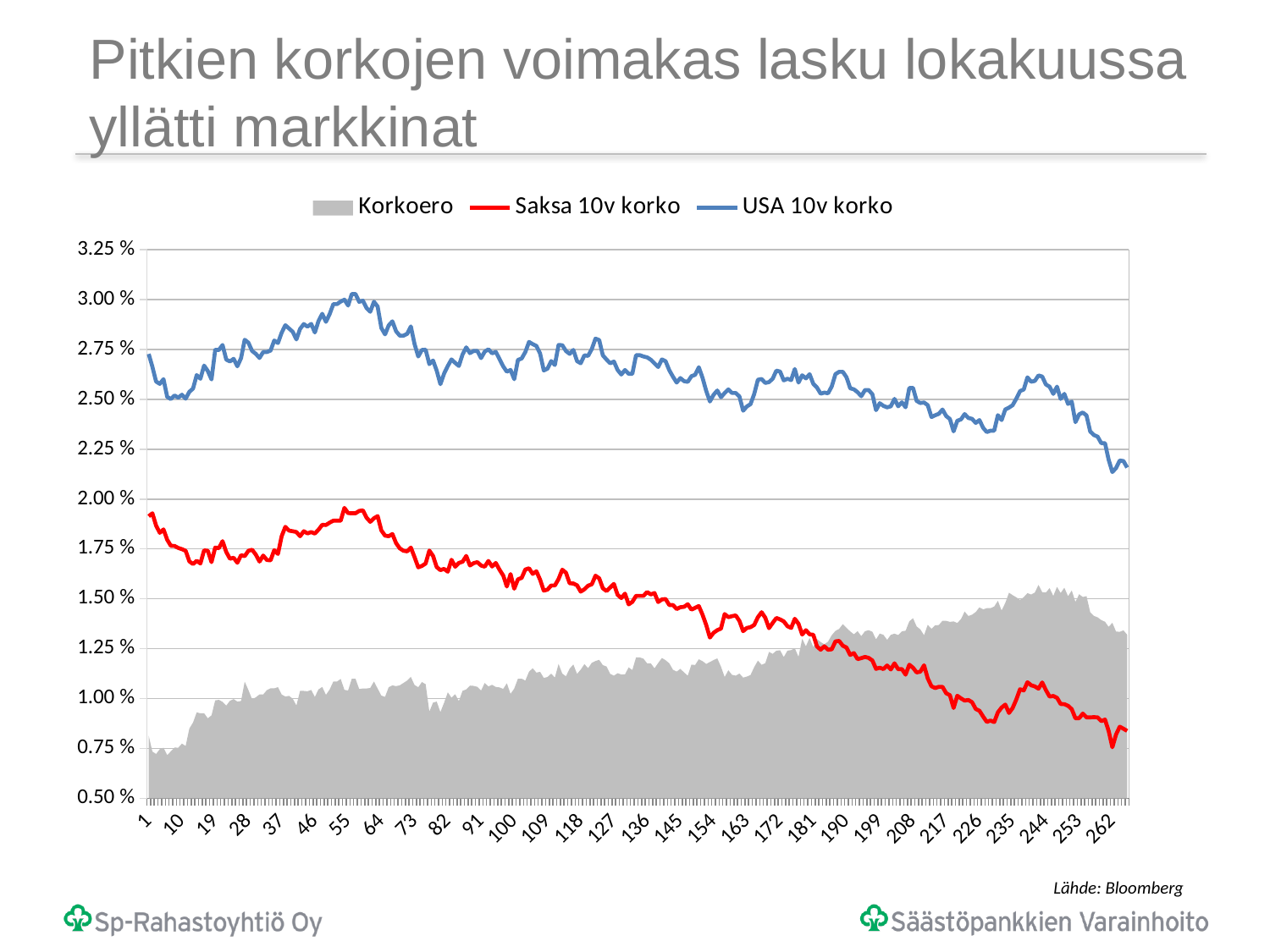
What kind of chart is used for the Saksa 10v korko and USA 10v korko series? line chart What colour is the Saksa 10v korko line? red Is the value of USA 10v korko at point 1 greater or less than 2.50 %? greater Which series is higher throughout the chart, USA 10v korko or Saksa 10v korko? USA 10v korko Is the value of Saksa 10v korko at point 1 greater or less than 1.75 %? greater Is the Korkoero value at the last point greater or less than 1.25 %? greater Does the Saksa 10v korko series rise or fall overall from left to right? fall Does the Korkoero series rise or fall overall from left to right? rise Which series is drawn as a grey shaded area? Korkoero How many series does the legend list? 3